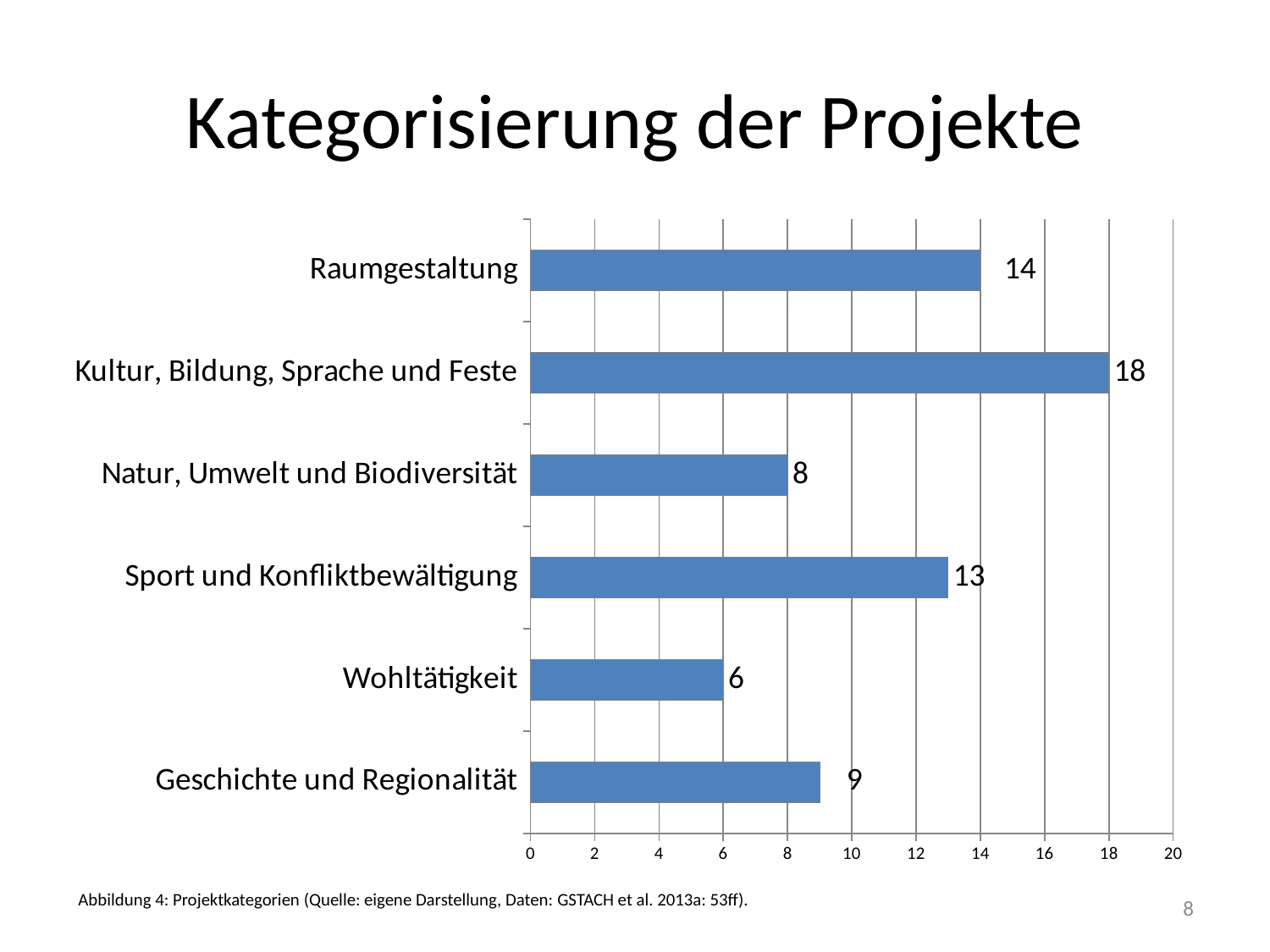
Is the value for Raumgestaltung greater or less than 10? greater What is the value for Raumgestaltung? 14 How many categories are shown in the chart? 6 What is the value for Wohltätigkeit? 6 What is the value for Geschichte und Regionalität? 9 Which category has the highest value? Kultur, Bildung, Sprache und Feste What is the title of the slide? Kategorisierung der Projekte What is the difference between the values for Kultur, Bildung, Sprache und Feste and Natur, Umwelt und Biodiversität? 10 Which category has the lowest value? Wohltätigkeit What is the value for Kultur, Bildung, Sprache und Feste? 18 What kind of chart is shown on the slide? bar chart Which is larger, the value for Sport und Konfliktbewältigung or the value for Geschichte und Regionalität? Sport und Konfliktbewältigung